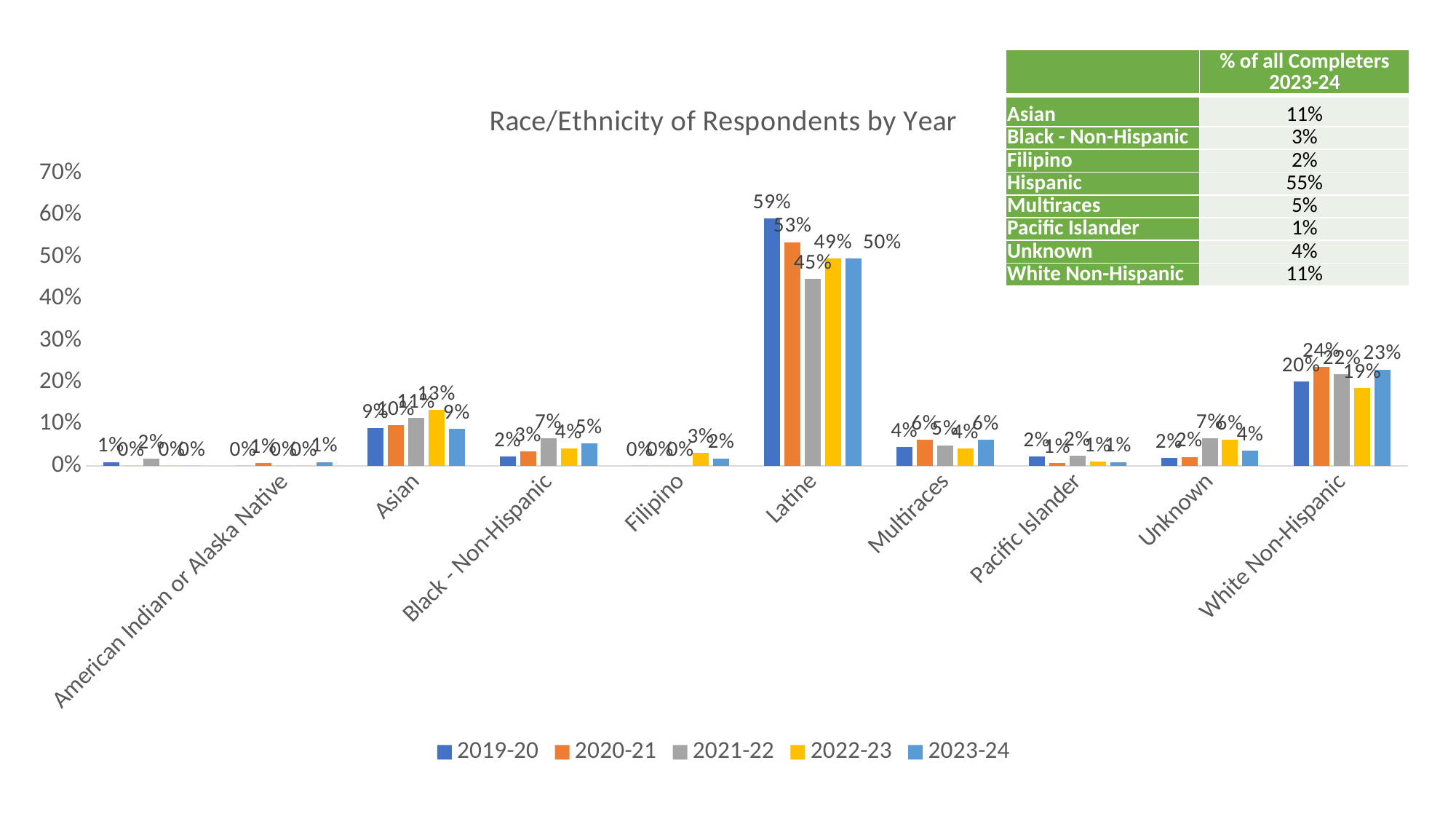
What kind of chart is shown? Bar chart Is the value for Latine in 2019-20 greater or less than 50%? greater Which is larger for White Non-Hispanic: the 2020-21 value or the 2022-23 value? 2020-21 What is the value for White Non-Hispanic in 2023-24? 23% What is the value for Latine in 2019-20? 59% What is the value for Unknown in 2021-22? 7% Which race/ethnicity category has the highest value in 2023-24? Latine What is the title of the chart? Race/Ethnicity of Respondents by Year What is the value for Asian in 2022-23? 13% How many series does the legend list? 5 Which year has the lowest value for White Non-Hispanic? 2022-23 What is the difference between the Latine values for 2019-20 and 2021-22? 14 percentage points